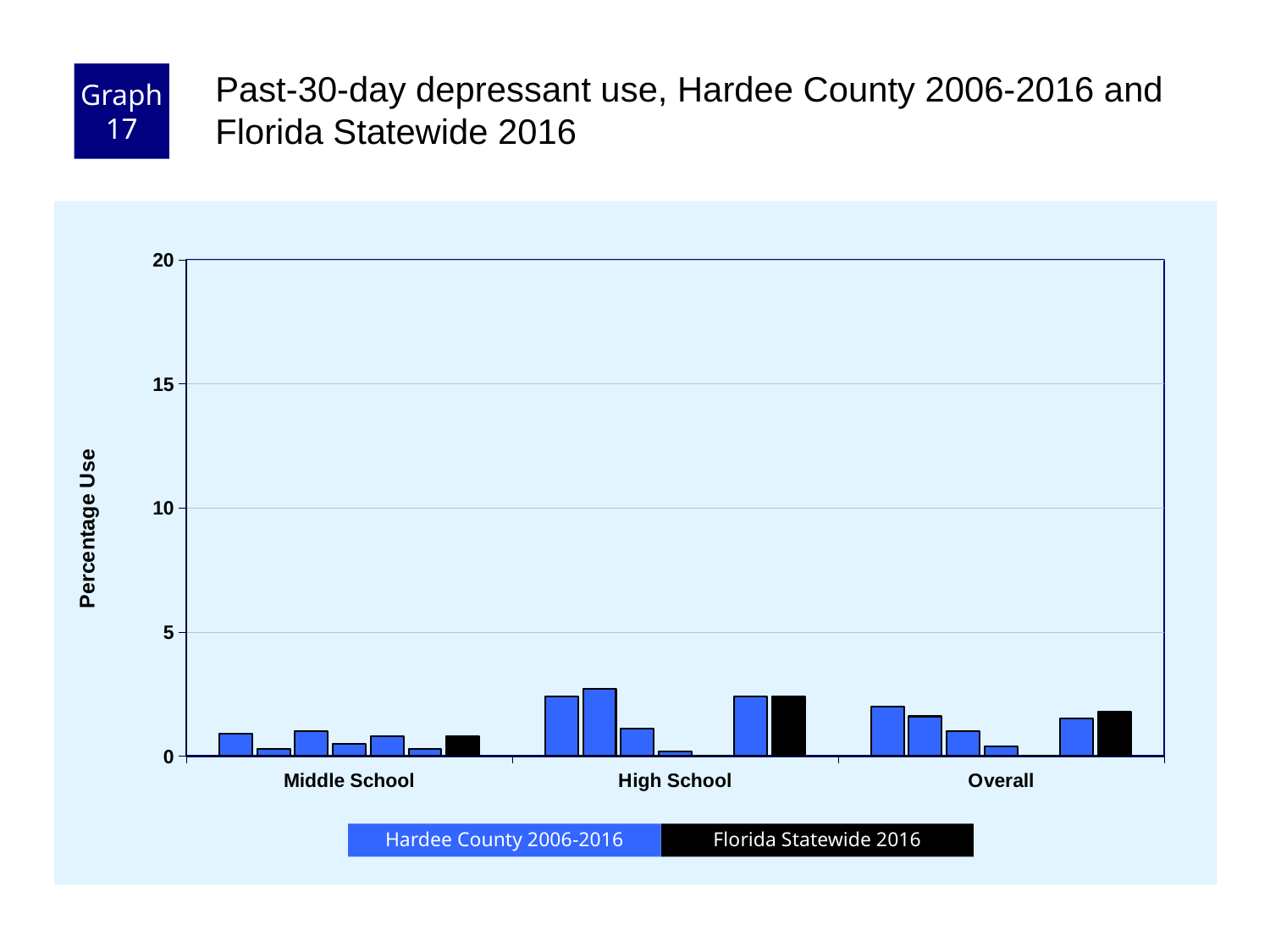
Is the Florida Statewide 2016 value larger for High School or for Middle School? High School Is the Florida Statewide 2016 value for Overall greater or less than 5? less Is the Florida Statewide 2016 value larger for Overall or for Middle School? Overall Which category has the lowest Florida Statewide 2016 value? Middle School Is the Florida Statewide 2016 value for High School greater or less than 5? less Is the Florida Statewide 2016 value for Middle School greater or less than 5? less How many series does the chart's legend list? 2 How many categories are shown on the x axis of the chart? 3 What kind of chart is shown on the slide? bar chart Which category has the highest Florida Statewide 2016 value? High School Which colour represents Florida Statewide 2016 in the chart's legend? black What is the label on the chart's vertical axis? Percentage Use